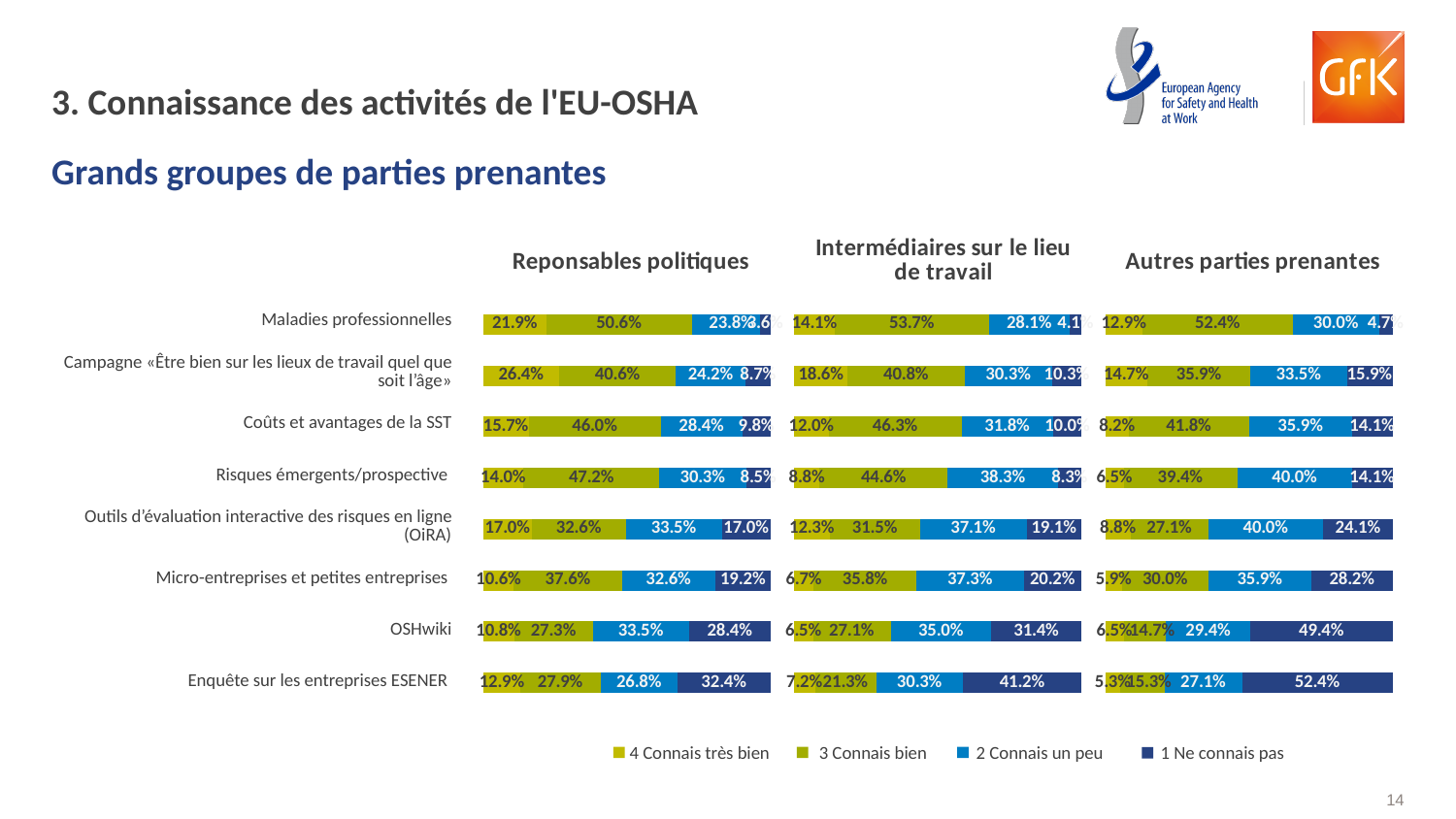
In the 'Intermédiaires sur le lieu de travail' chart, which category has the lowest value for '3 Connais bien'? Enquête sur les entreprises ESENER In the 'Intermédiaires sur le lieu de travail' chart, what is the value of '1 Ne connais pas' for 'Enquête sur les entreprises ESENER'? 41.2% How many categories are shown in the 'Autres parties prenantes' chart? 8 In the 'Autres parties prenantes' chart, which category has the highest value for '1 Ne connais pas'? Enquête sur les entreprises ESENER In the 'Intermédiaires sur le lieu de travail' chart, which is larger for 'Micro-entreprises et petites entreprises': '3 Connais bien' or '2 Connais un peu'? 2 Connais un peu In the 'Responsables politiques' chart, what is the difference between the '1 Ne connais pas' values for 'Enquête sur les entreprises ESENER' and 'OSHwiki'? 4.0% In the 'Responsables politiques' chart, which category has the highest value for '4 Connais très bien'? Campagne «Être bien sur les lieux de travail quel que soit l'âge» How many series does the legend list? 4 In the 'Autres parties prenantes' chart, what is the value of '2 Connais un peu' for 'Outils d'évaluation interactive des risques en ligne (OiRA)'? 40.0% What is the title of the middle chart? Intermédiaires sur le lieu de travail What kind of chart is the 'Responsables politiques' chart? Stacked bar chart In the 'Responsables politiques' chart, what is the value of '3 Connais bien' for 'Maladies professionnelles'? 50.6%